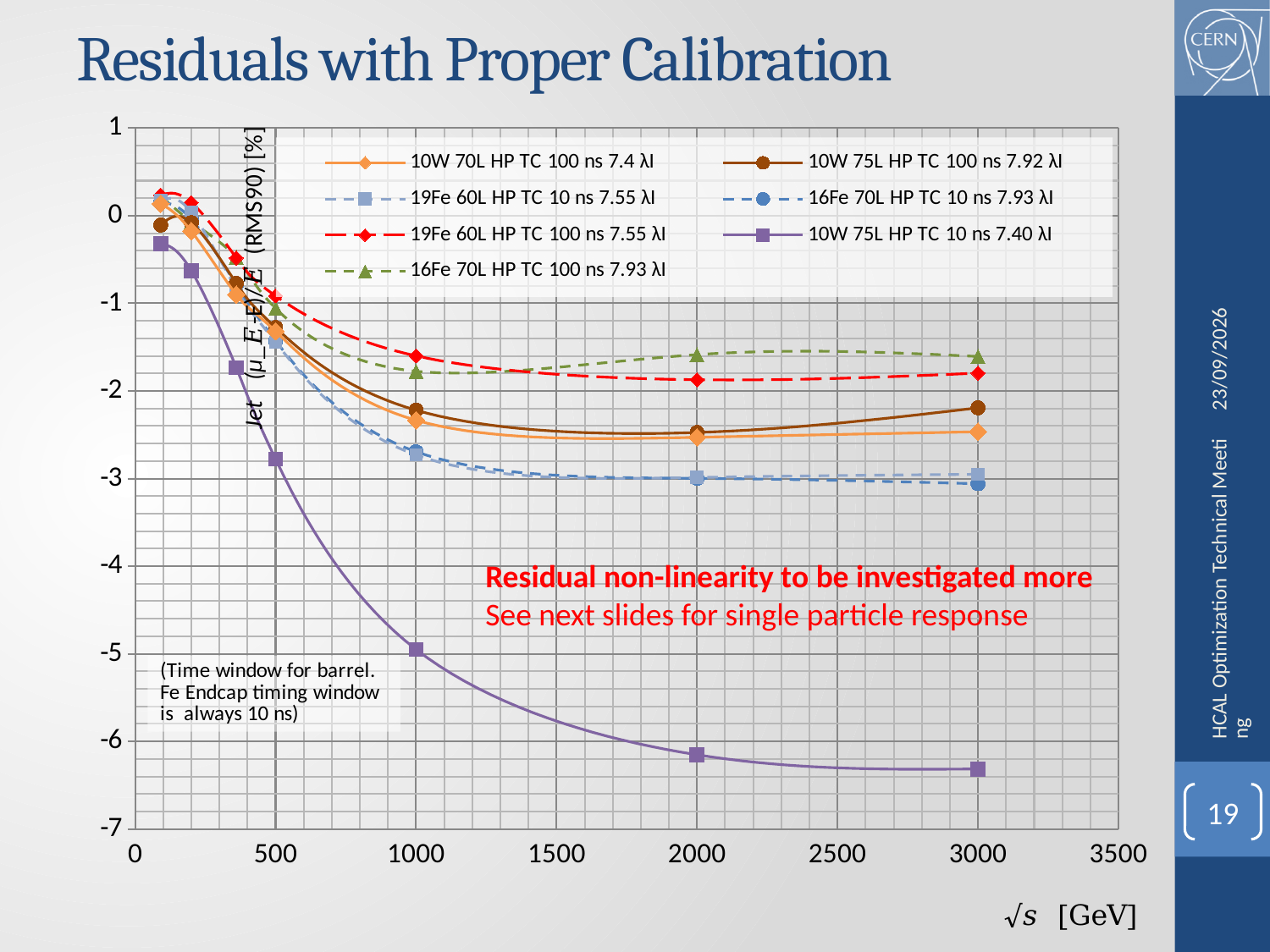
What kind of chart is shown on the slide? line chart Is the value for 19Fe 60L HP TC 100 ns 7.55 λI at 2000 GeV greater or less than -2? greater Which series has the lowest value at 3000 GeV? 10W 75L HP TC 10 ns 7.40 λI At 3000 GeV, which is larger: the value for 10W 75L HP TC 100 ns 7.92 λI or for 10W 70L HP TC 100 ns 7.4 λI? 10W 75L HP TC 100 ns 7.92 λI Which series has the highest value at 3000 GeV? 16Fe 70L HP TC 100 ns 7.93 λI Does the 10W 75L HP TC 10 ns 7.40 λI series rise or fall as √s increases from 100 to 3000 GeV? fall How many series does the legend list? 7 Is the value for 10W 75L HP TC 10 ns 7.40 λI at 3000 GeV greater or less than -6? less What is the label of the x axis? √s [GeV] Is the value for 10W 75L HP TC 10 ns 7.40 λI at 2000 GeV greater or less than -5? less What is the title of the chart? Residuals with Proper Calibration